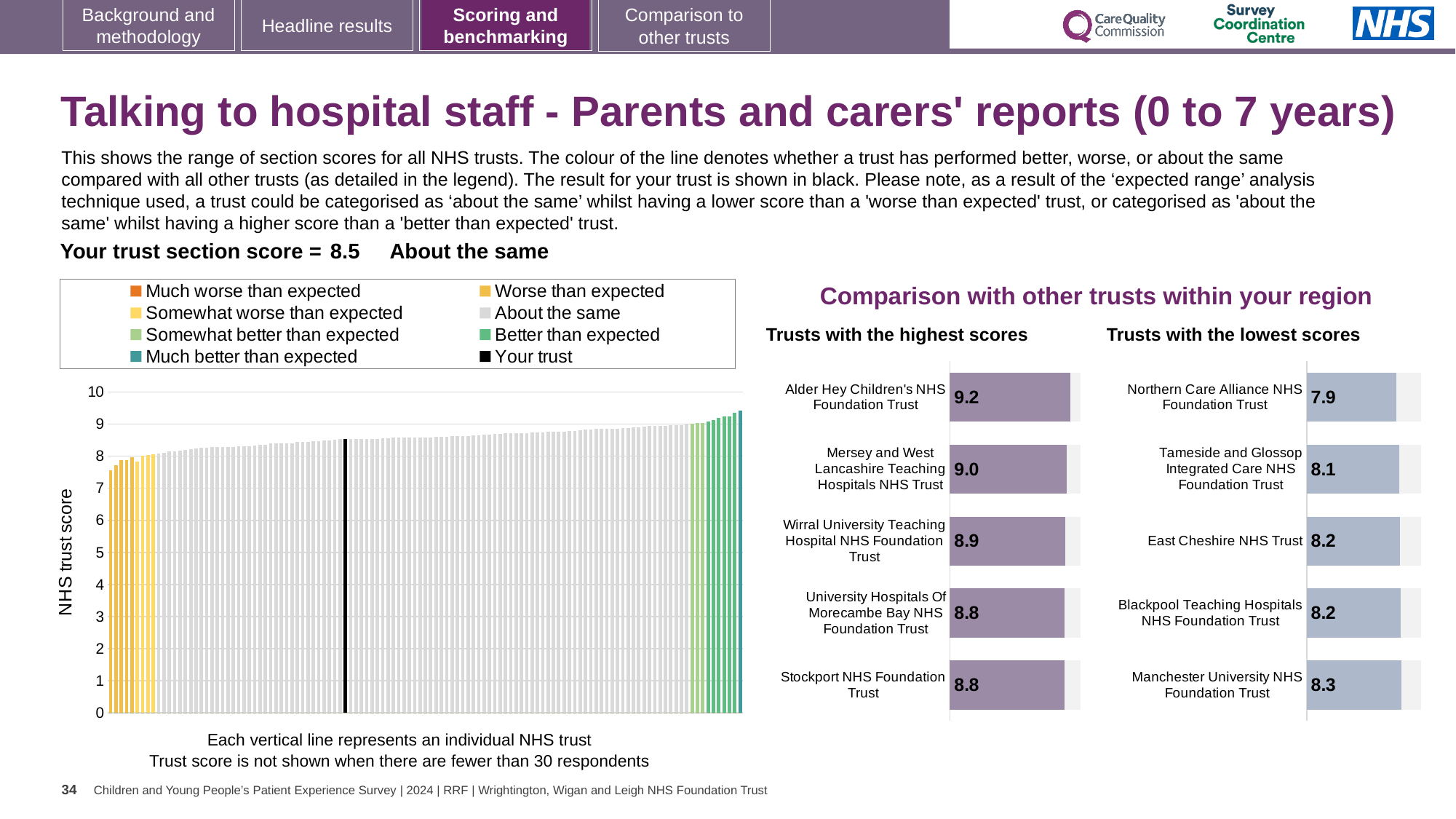
In the 'Trusts with the lowest scores' chart, what is the score for Manchester University NHS Foundation Trust? 8.3 In the 'Trusts with the lowest scores' chart, which trust has the lowest score? Northern Care Alliance NHS Foundation Trust In the large chart on the left, do the trust scores rise or fall from left to right along the x axis? rise In the large chart on the left, is the value for 'Your trust' (the black line) greater or less than 8? greater In the 'Trusts with the highest scores' chart, what is the difference between the scores of Alder Hey Children's NHS Foundation Trust and Stockport NHS Foundation Trust? 0.4 In the 'Trusts with the highest scores' chart, which trust has the highest score? Alder Hey Children's NHS Foundation Trust How many entries does the legend of the large chart on the left list? 8 In the 'Trusts with the lowest scores' chart, which has the larger score: Tameside and Glossop Integrated Care NHS Foundation Trust or Manchester University NHS Foundation Trust? Manchester University NHS Foundation Trust In the 'Trusts with the highest scores' chart, what is the score for Alder Hey Children's NHS Foundation Trust? 9.2 In the 'Trusts with the lowest scores' chart, what is the score for Northern Care Alliance NHS Foundation Trust? 7.9 How many trusts are shown in the 'Trusts with the highest scores' chart? 5 In the 'Trusts with the highest scores' chart, what is the score for Wirral University Teaching Hospital NHS Foundation Trust? 8.9